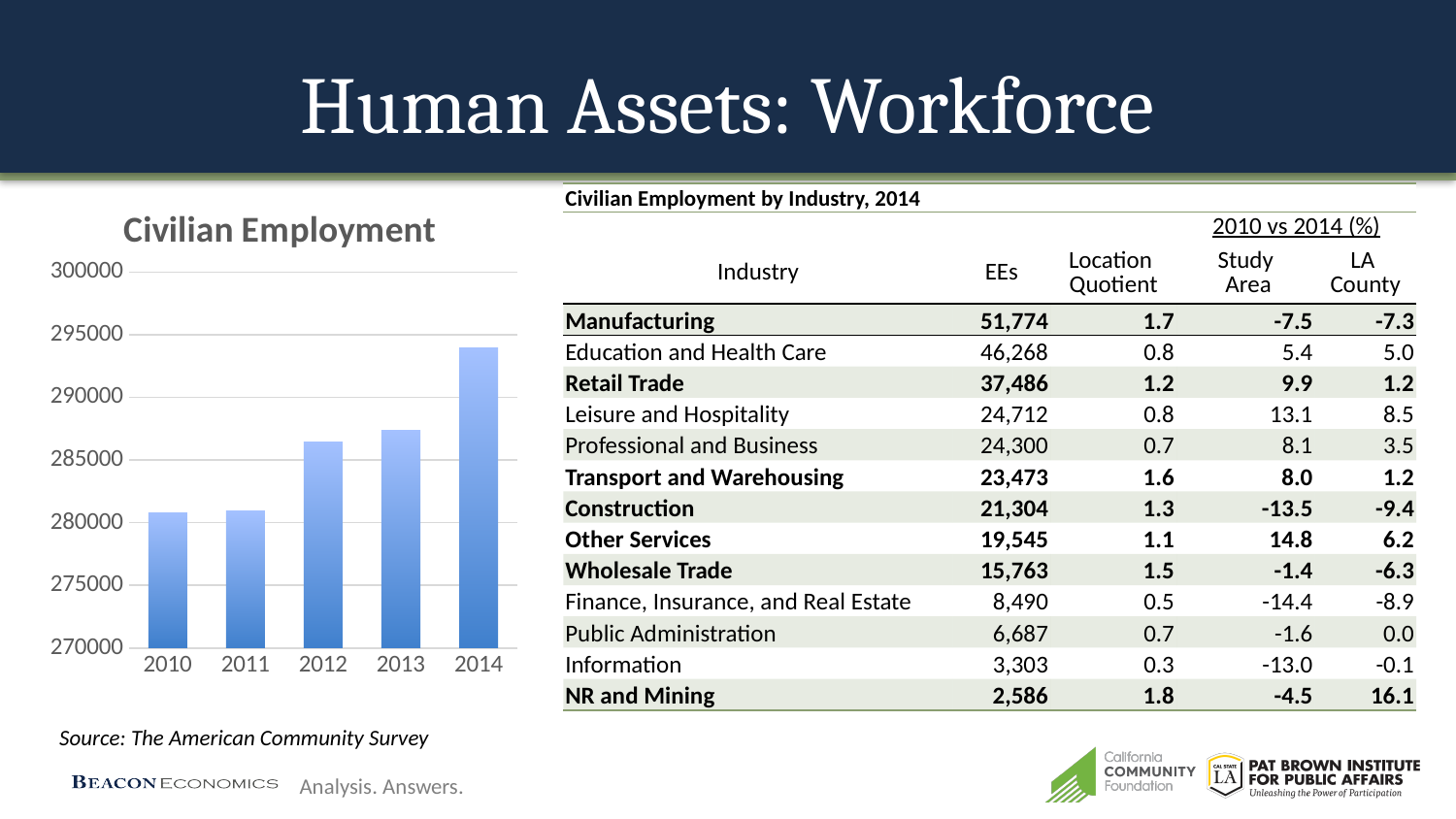
Is the value for 2014 in the Civilian Employment chart greater or less than 290000? greater What is the title of the chart on the slide? Civilian Employment Do the values in the Civilian Employment chart rise or fall from 2010 to 2014? rise How many years are plotted in the Civilian Employment chart? 5 Is the value for 2010 in the Civilian Employment chart greater or less than 285000? less Is the value for 2013 in the Civilian Employment chart greater or less than 290000? less Which year has the highest civilian employment in the chart? 2014 What is the first year shown on the x axis of the Civilian Employment chart? 2010 In the Civilian Employment chart, which is larger, the value for 2014 or the value for 2012? 2014 What kind of chart is shown on the slide? bar chart